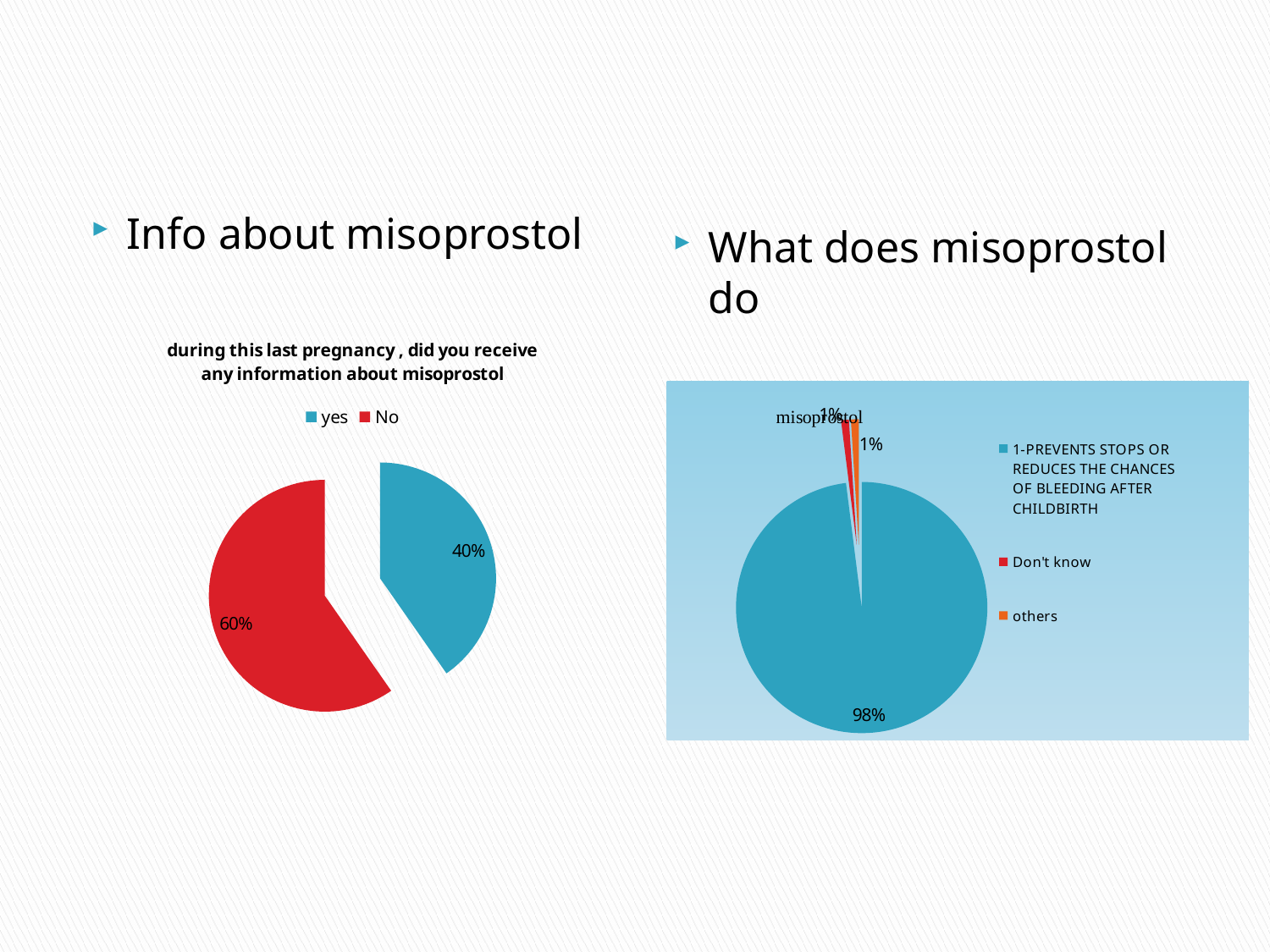
In the left pie chart about receiving information about misoprostol, what share of respondents answered "No"? 60% In the left pie chart, what colour is the "No" slice? Red In the right pie chart about what misoprostol does, what share corresponds to "1-PREVENTS STOPS OR REDUCES THE CHANCES OF BLEEDING AFTER CHILDBIRTH"? 98% In the left pie chart about receiving information about misoprostol, what share of respondents answered "yes"? 40% In the right pie chart about what misoprostol does, what share corresponds to "others"? 1% In the right pie chart about what misoprostol does, what share corresponds to "Don't know"? 1% In the right pie chart about what misoprostol does, how many categories does the legend list? 3 In the right pie chart about what misoprostol does, which category has the largest slice? 1-PREVENTS STOPS OR REDUCES THE CHANCES OF BLEEDING AFTER CHILDBIRTH What type of chart is the left chart about receiving information about misoprostol? Pie chart In the left pie chart about receiving information about misoprostol, how many entries does the legend list? 2 In the left pie chart about receiving information about misoprostol, which answer has the larger share? No In the left pie chart about receiving information about misoprostol, what is the difference in percentage points between the "No" and "yes" slices? 20 percentage points